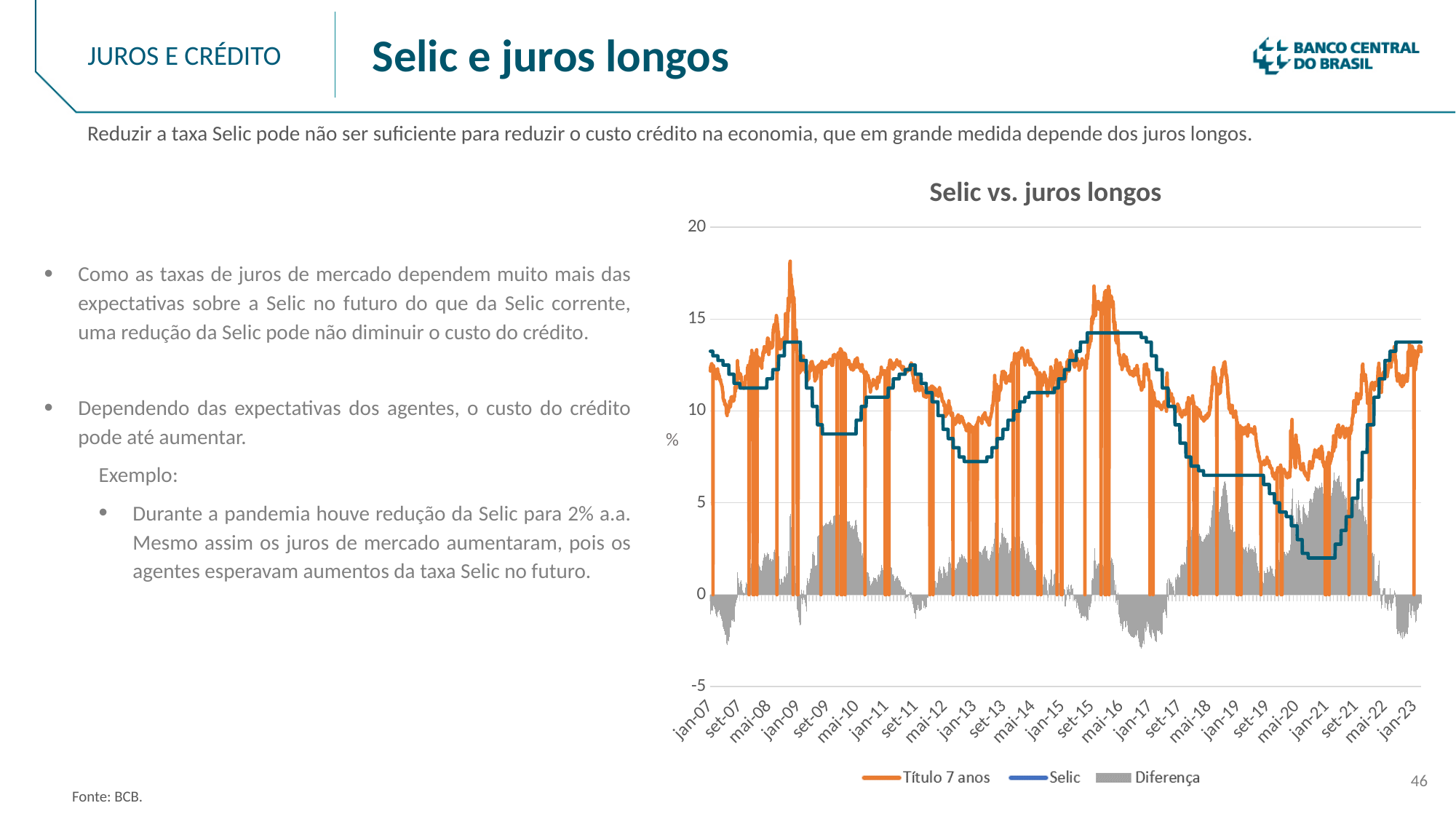
Is the Selic value around jan-21 greater or less than 5? less Is the Selic value around set-15 greater or less than 10? greater Is the Diferença value around jan-17 greater or less than 0? less What is the title of the chart? Selic vs. juros longos Which series is drawn in orange in the chart? Título 7 anos What kind of chart is shown on the slide? combination line and bar chart What is the highest value shown on the vertical axis of the chart? 20 Does the Selic series rise or fall between jan-21 and jan-23? rise Does the Selic series rise or fall between jan-17 and jan-18? fall How many series does the legend of the chart list? 3